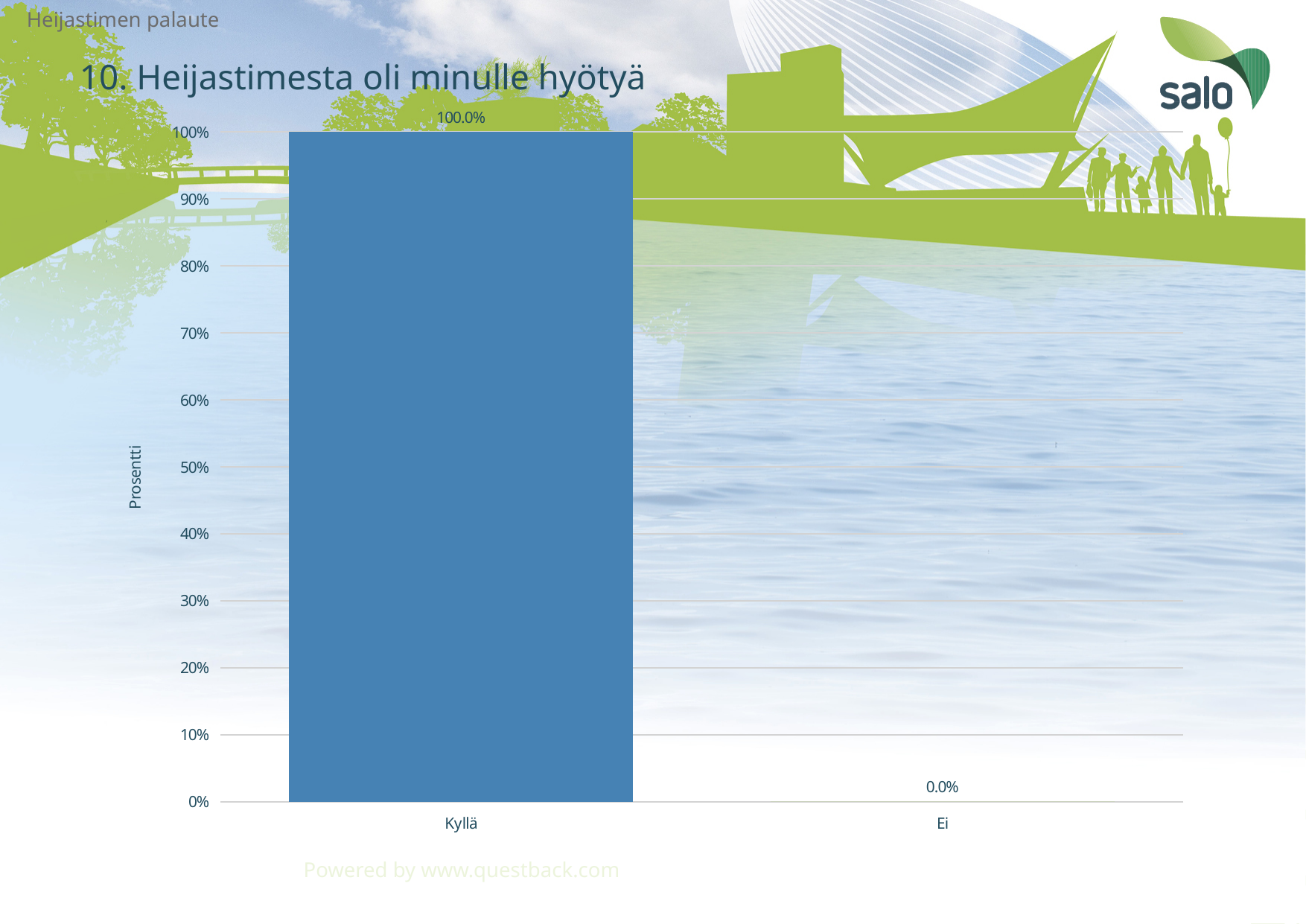
What is the title of the chart? 10. Heijastimesta oli minulle hyötyä What is the difference between the values for Kyllä and Ei? 100.0% Which category has the highest value? Kyllä What is the value for Ei? 0.0% What is the value for Kyllä? 100.0% How many categories are shown on the x axis? 2 Which is larger, the value for Kyllä or the value for Ei? Kyllä What is the label of the vertical axis? Prosentti Which category has the lowest value? Ei What kind of chart is shown on the slide? bar chart Is the value for Kyllä greater or less than 50%? greater